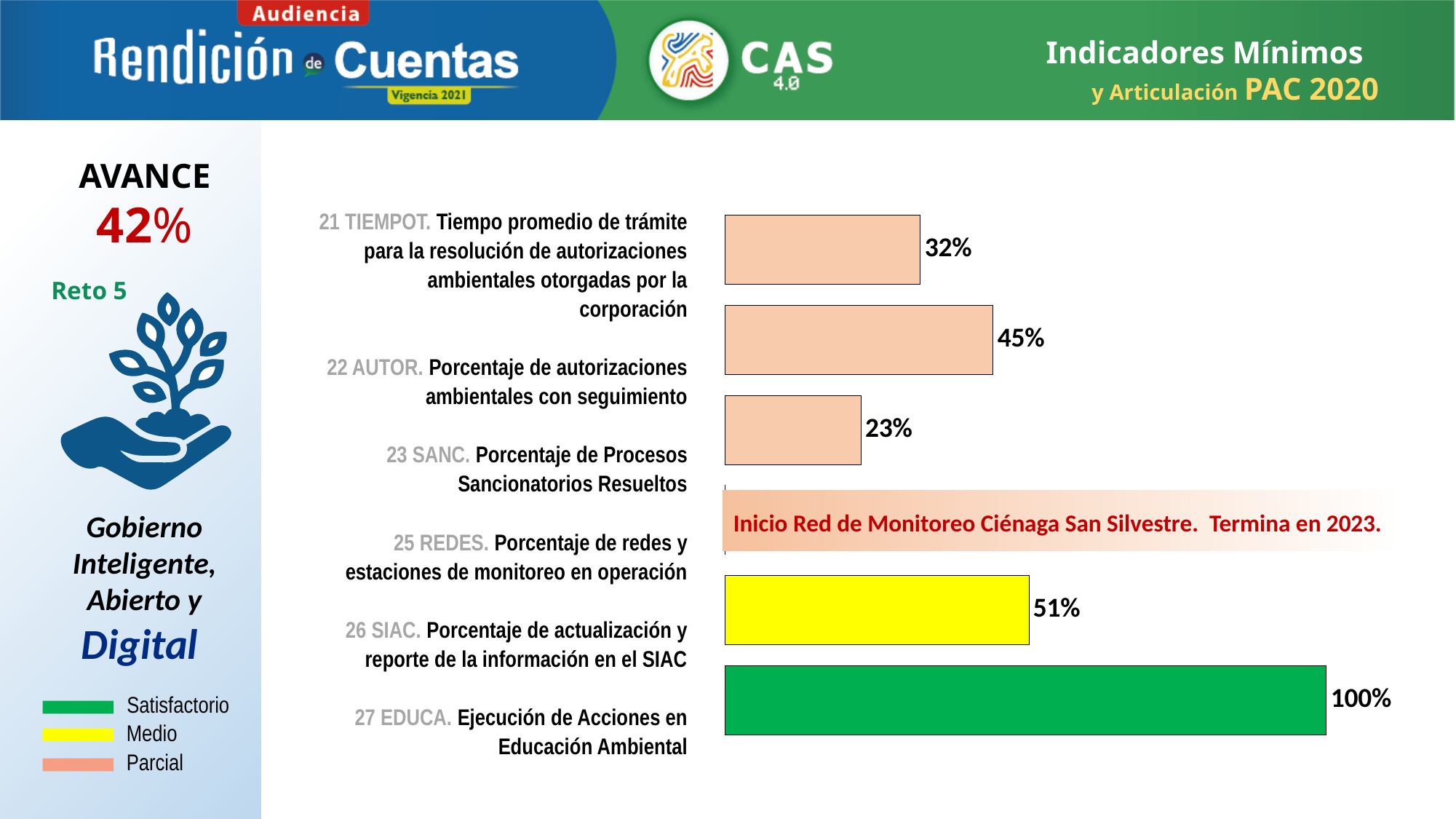
Which indicator with a plotted bar has the lowest value? 23 SANC How many indicators have a bar plotted in the chart? 5 What is the value for indicator 23 SANC (Porcentaje de Procesos Sancionatorios Resueltos)? 23% What type of chart is shown on the slide? Bar chart What is the value for indicator 26 SIAC (Porcentaje de actualización y reporte de la información en el SIAC)? 51% Which is larger, the value for 21 TIEMPOT or the value for 23 SANC? 21 TIEMPOT What is the value for indicator 27 EDUCA (Ejecución de Acciones en Educación Ambiental)? 100% What is the value for indicator 22 AUTOR (Porcentaje de autorizaciones ambientales con seguimiento)? 45% According to the legend, what colour represents the 'Satisfactorio' level? Green What is the value for indicator 21 TIEMPOT (Tiempo promedio de trámite para la resolución de autorizaciones ambientales)? 32% What is the difference between the values for 26 SIAC and 22 AUTOR? 6% Which indicator has the highest value in the chart? 27 EDUCA